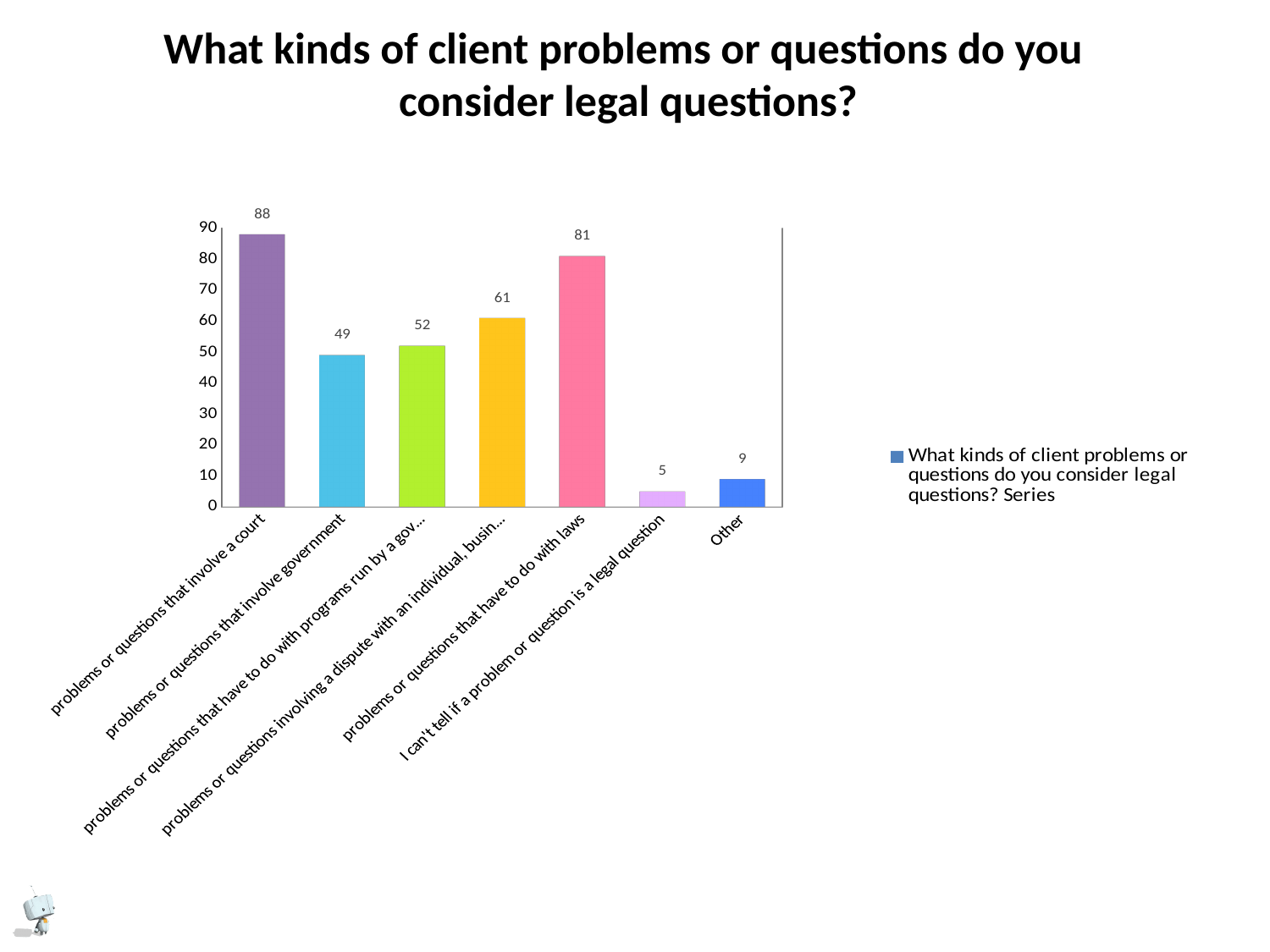
Which is larger: the value for 'problems or questions that involve government' or the value for 'Other'? problems or questions that involve government What is the difference between the values for 'problems or questions that involve a court' and 'problems or questions that have to do with laws'? 7 How many categories are shown on the x axis? 7 What is the value for 'problems or questions that involve a court'? 88 What is the value for 'problems or questions that have to do with laws'? 81 What is the value for 'problems or questions that involve government'? 49 Which category has the lowest value? I can't tell if a problem or question is a legal question What is the value for 'Other'? 9 Is the value for 'problems or questions that have to do with laws' greater or less than 70? greater Which category has the highest value? problems or questions that involve a court What is the title of the chart? What kinds of client problems or questions do you consider legal questions? What kind of chart is shown on the slide? bar chart